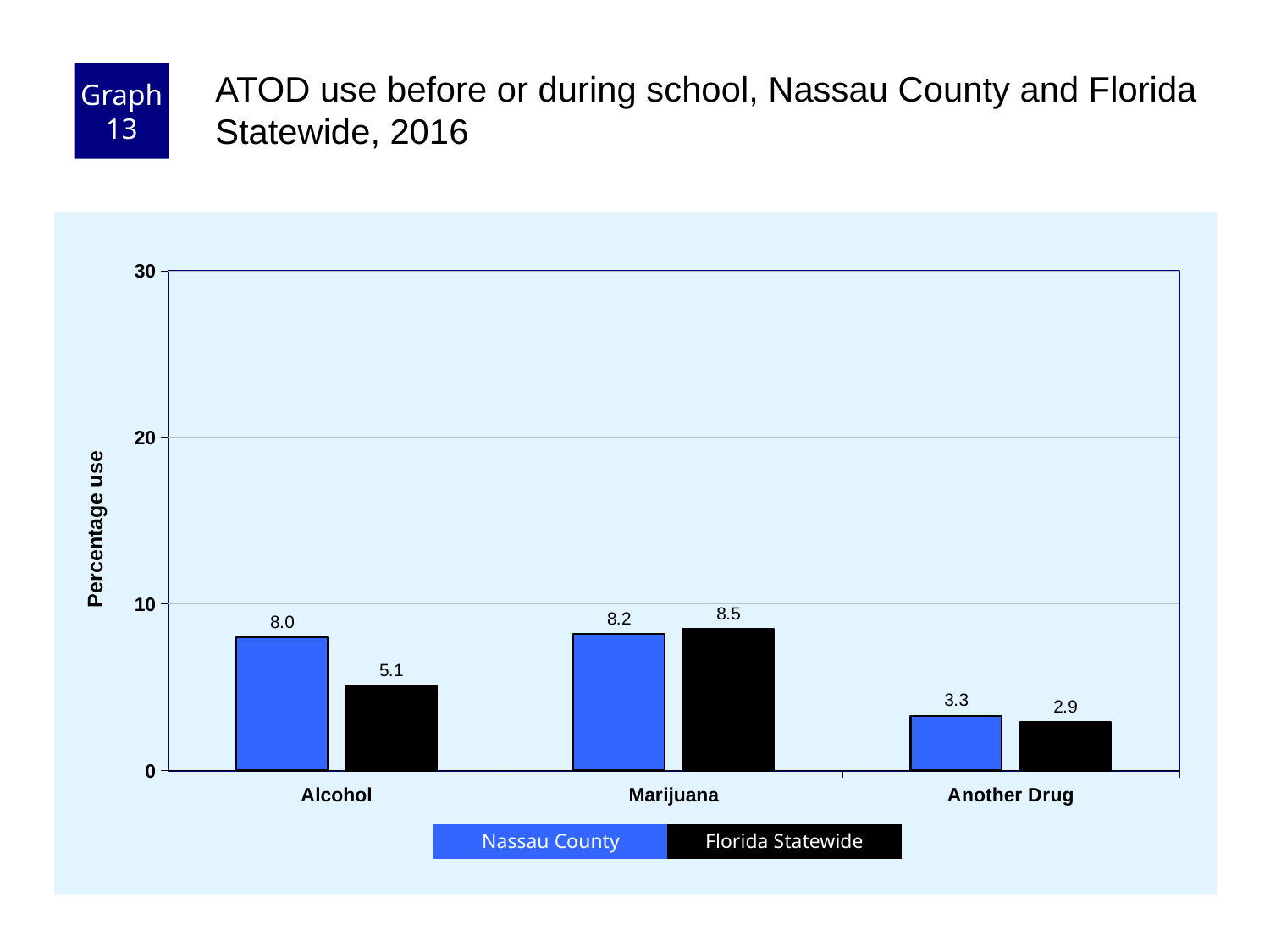
How many categories are shown on the x axis? 3 What kind of chart is shown on the slide? bar chart What is the Florida Statewide value for Alcohol? 5.1 Is the Florida Statewide value for Marijuana greater or less than 10? less What is the Florida Statewide value for Marijuana? 8.5 Which category has the lowest Nassau County value? Another Drug Which is larger for Another Drug: Nassau County or Florida Statewide? Nassau County What is the difference between the Nassau County and Florida Statewide values for Alcohol? 2.9 What is the Nassau County value for Alcohol? 8.0 Which category has the highest Florida Statewide value? Marijuana How many series does the legend list? 2 What is the Nassau County value for Another Drug? 3.3